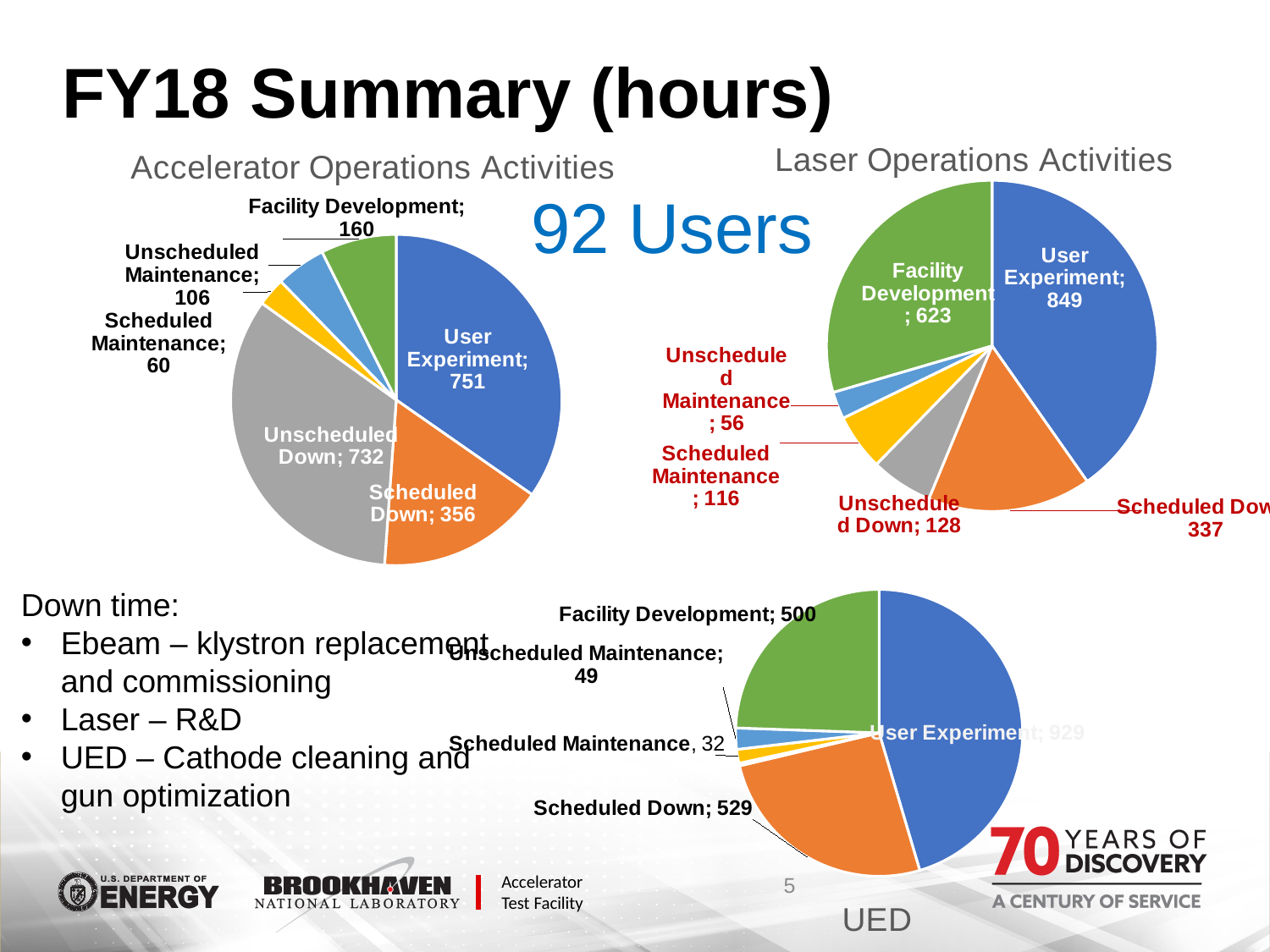
In the Laser Operations Activities chart, which category has the smallest slice? Unscheduled Maintenance How many slices does the Accelerator Operations Activities chart have? 6 In the Accelerator Operations Activities chart, how many hours are shown for User Experiment? 751 In the Accelerator Operations Activities chart, which category has the smallest slice? Scheduled Maintenance In the Laser Operations Activities chart, how many hours are shown for Unscheduled Maintenance? 56 In the Laser Operations Activities chart, how many more hours does User Experiment have than Facility Development? 226 What type of chart is the Accelerator Operations Activities chart? Pie chart In the Laser Operations Activities chart, how many hours are shown for Facility Development? 623 In the Laser Operations Activities chart, which is larger: Scheduled Down or Unscheduled Down? Scheduled Down In the Laser Operations Activities chart, which category has the largest slice? User Experiment In the Accelerator Operations Activities chart, what is the difference in hours between Unscheduled Down and Scheduled Down? 376 In the UED chart at the bottom of the slide, how many hours are shown for Scheduled Down? 529